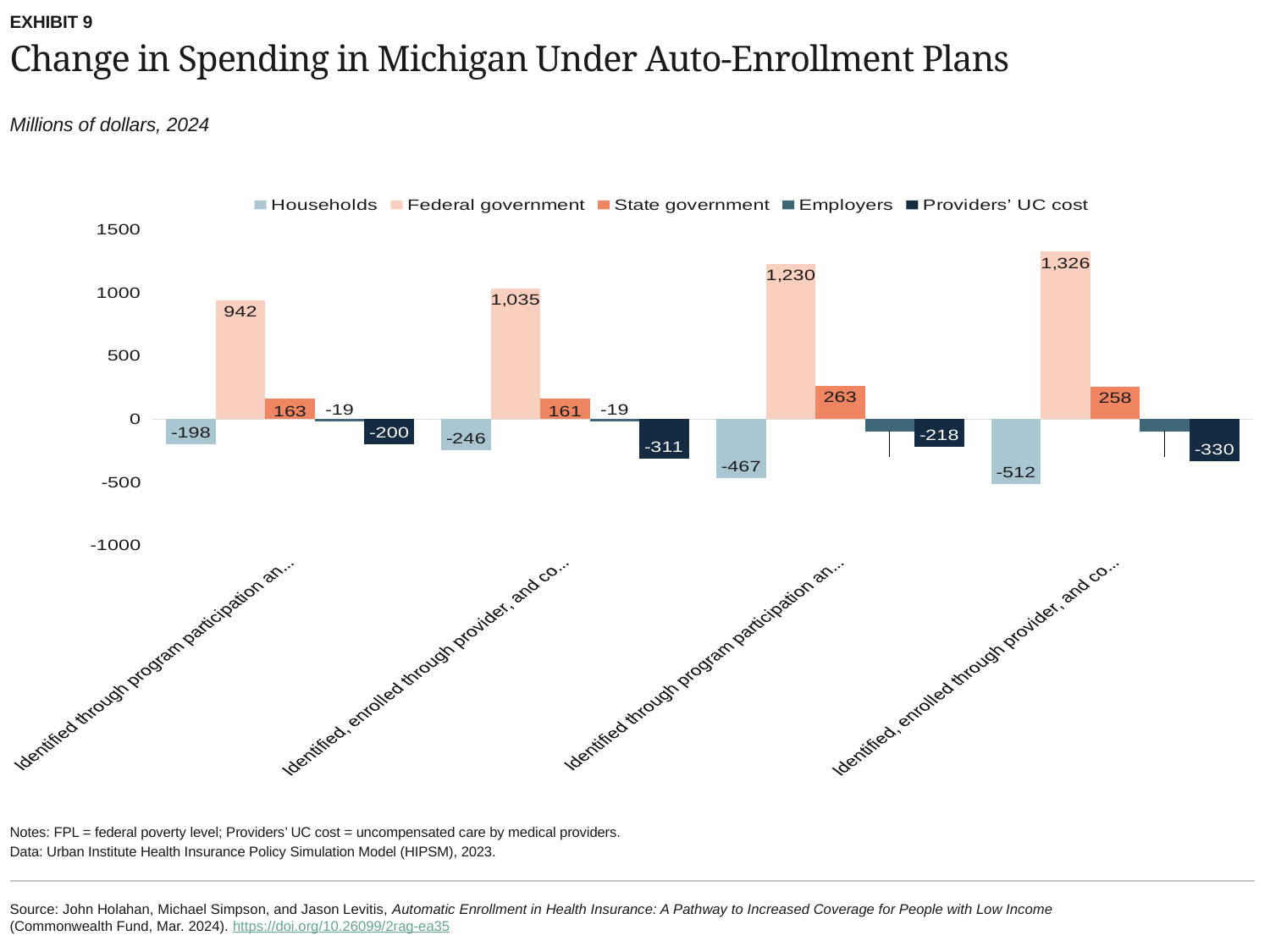
What is the Households value for the fourth (rightmost) category group? -512 Which category group has the highest Federal government value? the fourth (rightmost) group Is the State government value larger in the first category group or the second category group? the first group How many series does the legend list? 5 What type of chart is shown on the slide? bar chart What is the difference between the Federal government values of the fourth and third category groups? 96 Is the Federal government value for the third category group greater or less than 1000? greater What is the Providers' UC cost value for the second category group? -311 Which category group has the lowest Households value? the fourth (rightmost) group What is the State government value for the third category group? 263 What is the Federal government value for the first (leftmost) category group? 942 How many category groups are plotted along the x axis? 4